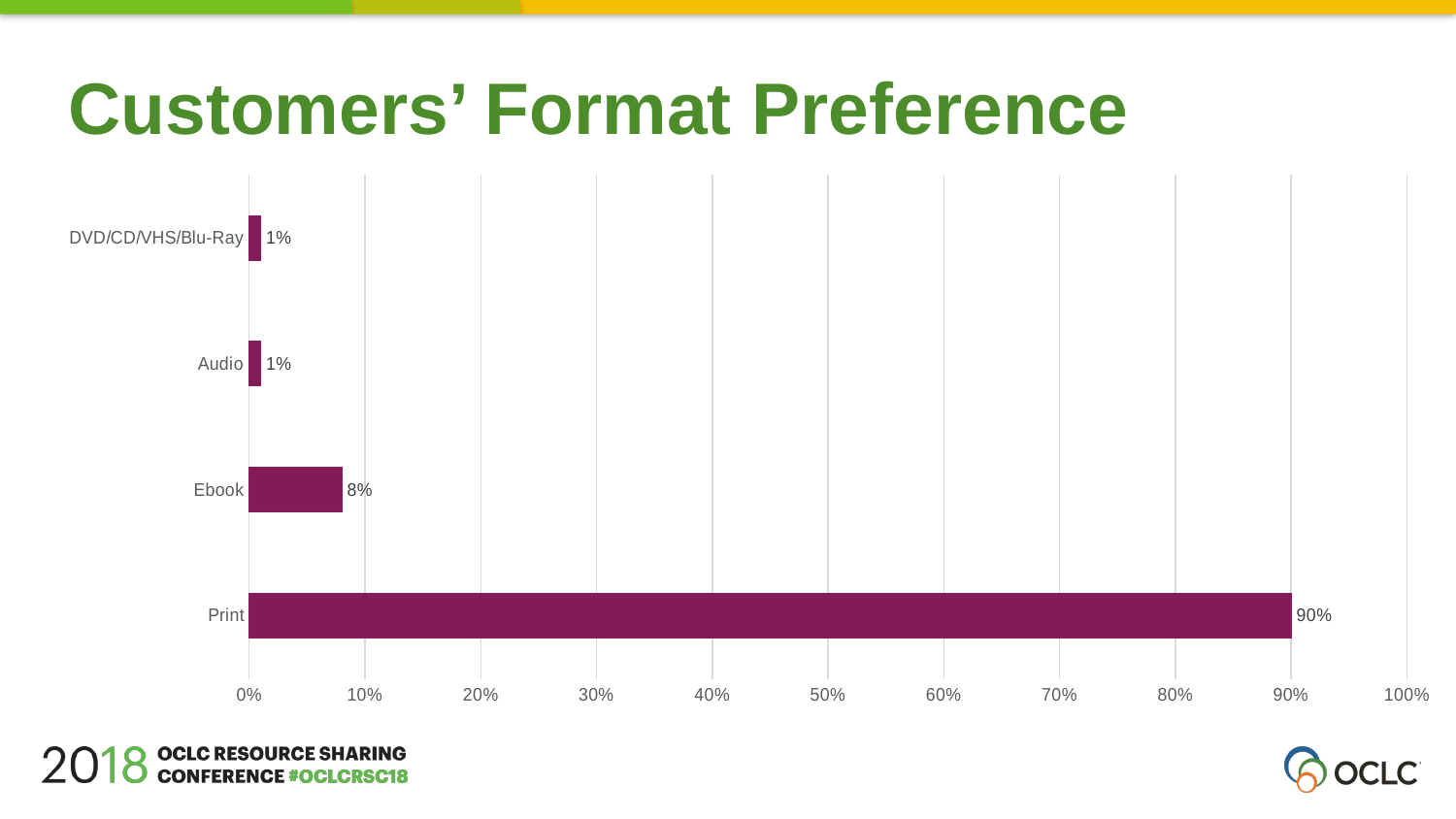
How many formats are shown in the chart? 4 Which format has the highest value? Print Which is larger, the value for Ebook or the value for Audio? Ebook What is the difference between the values for Ebook and Audio? 7% What is the difference between the values for Print and Ebook? 82% Is the value for Print greater or less than 50%? greater What is the value for DVD/CD/VHS/Blu-Ray? 1% What kind of chart is shown on the slide? Bar chart What is the title of the slide? Customers' Format Preference What is the value for Ebook? 8% What is the value for Print? 90% What is the value for Audio? 1%